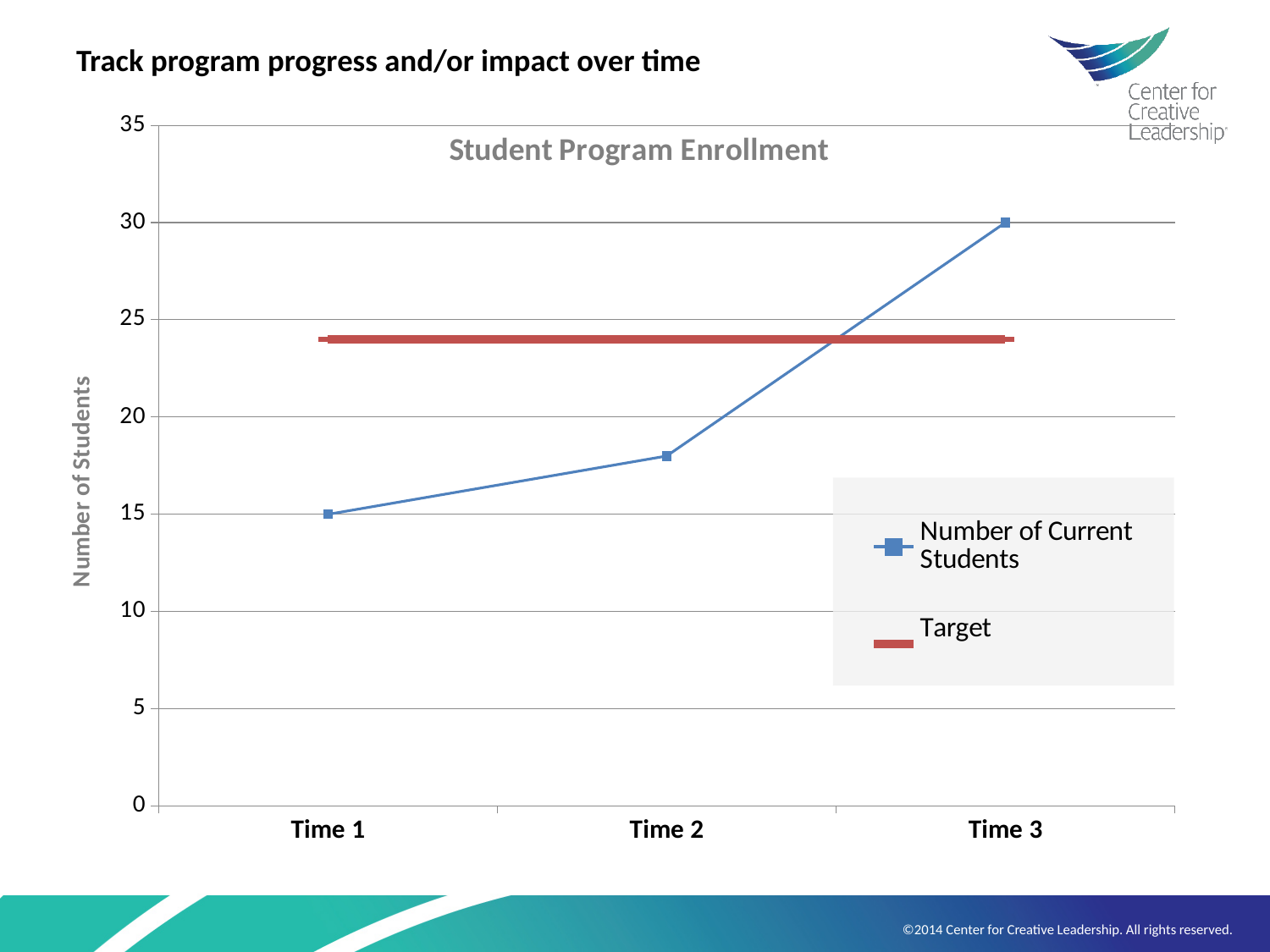
Is the Target value greater or less than 20? greater Does the Number of Current Students rise or fall from Time 1 to Time 3? rise How many series does the legend list? 2 What is the Number of Current Students at Time 1? 15 Is the Number of Current Students at Time 2 greater or less than 20? less At which time point is the Number of Current Students lowest? Time 1 How many time points are plotted on the x axis? 3 What kind of chart is shown on the slide? line chart What is the title of the chart? Student Program Enrollment What is the Number of Current Students at Time 3? 30 At which time point is the Number of Current Students highest? Time 3 By how much did the Number of Current Students increase from Time 1 to Time 3? 15